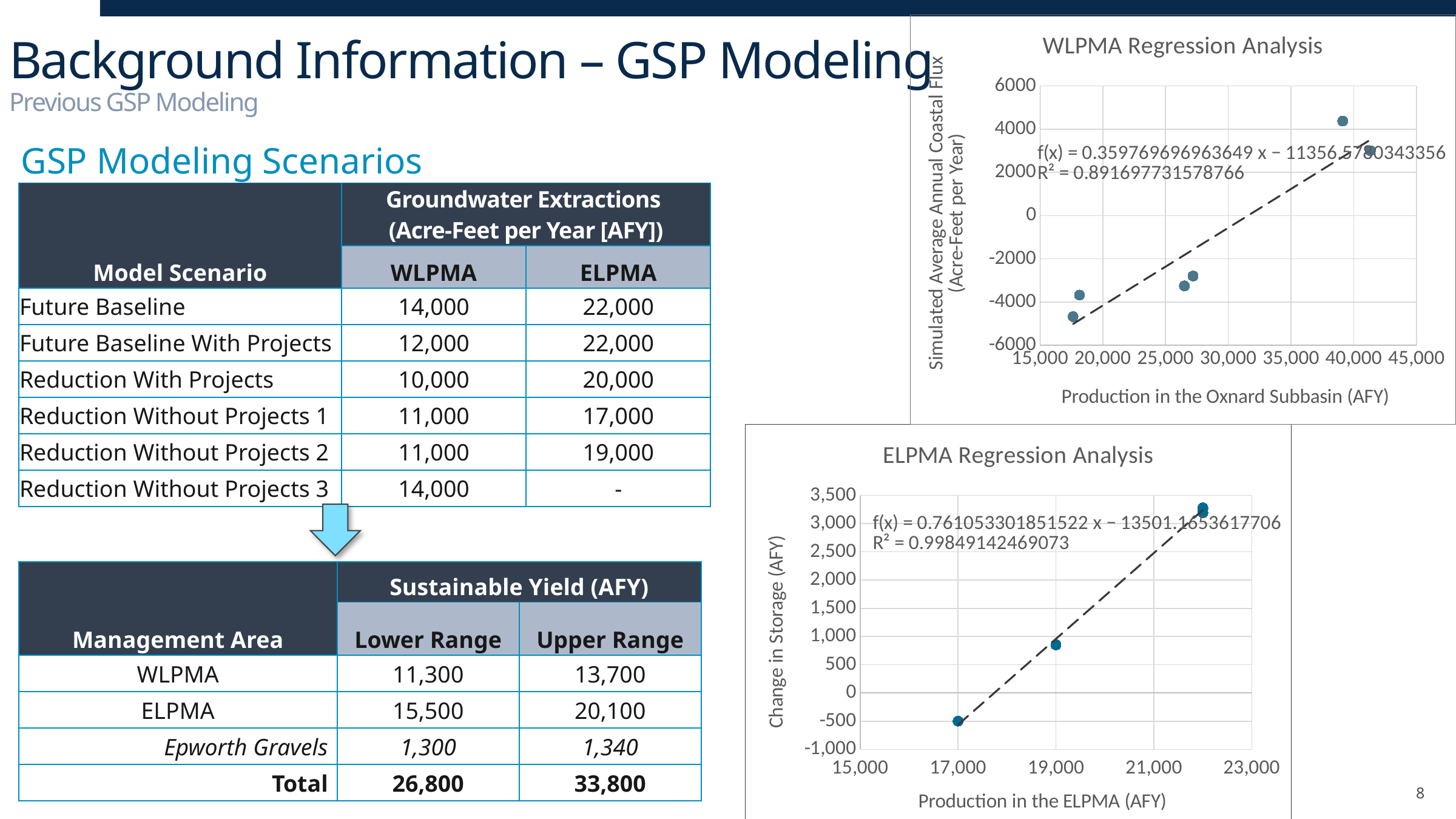
In the ELPMA Regression Analysis chart, what is the R² value printed on the chart? 0.99849142469073 What is the y-axis title of the ELPMA Regression Analysis chart? Change in Storage (AFY) What is the x-axis title of the WLPMA Regression Analysis chart? Production in the Oxnard Subbasin (AFY) In the WLPMA Regression Analysis chart, do the plotted values rise or fall as production increases along the x axis? Rise What kind of chart is the WLPMA Regression Analysis chart? Scatter chart In the ELPMA Regression Analysis chart, do the plotted values rise or fall as production increases along the x axis? Rise In the WLPMA Regression Analysis chart, is the coastal flux for the lowest plotted point greater or less than -4000? less In the ELPMA Regression Analysis chart, is the change in storage for the point at 19,000 AFY production greater or less than 500? greater In the ELPMA Regression Analysis chart, is the change in storage for the point at 17,000 AFY production greater or less than 0? less In the WLPMA Regression Analysis chart, what is the R² value printed on the chart? 0.891697731578766 What kind of chart is the ELPMA Regression Analysis chart? Scatter chart